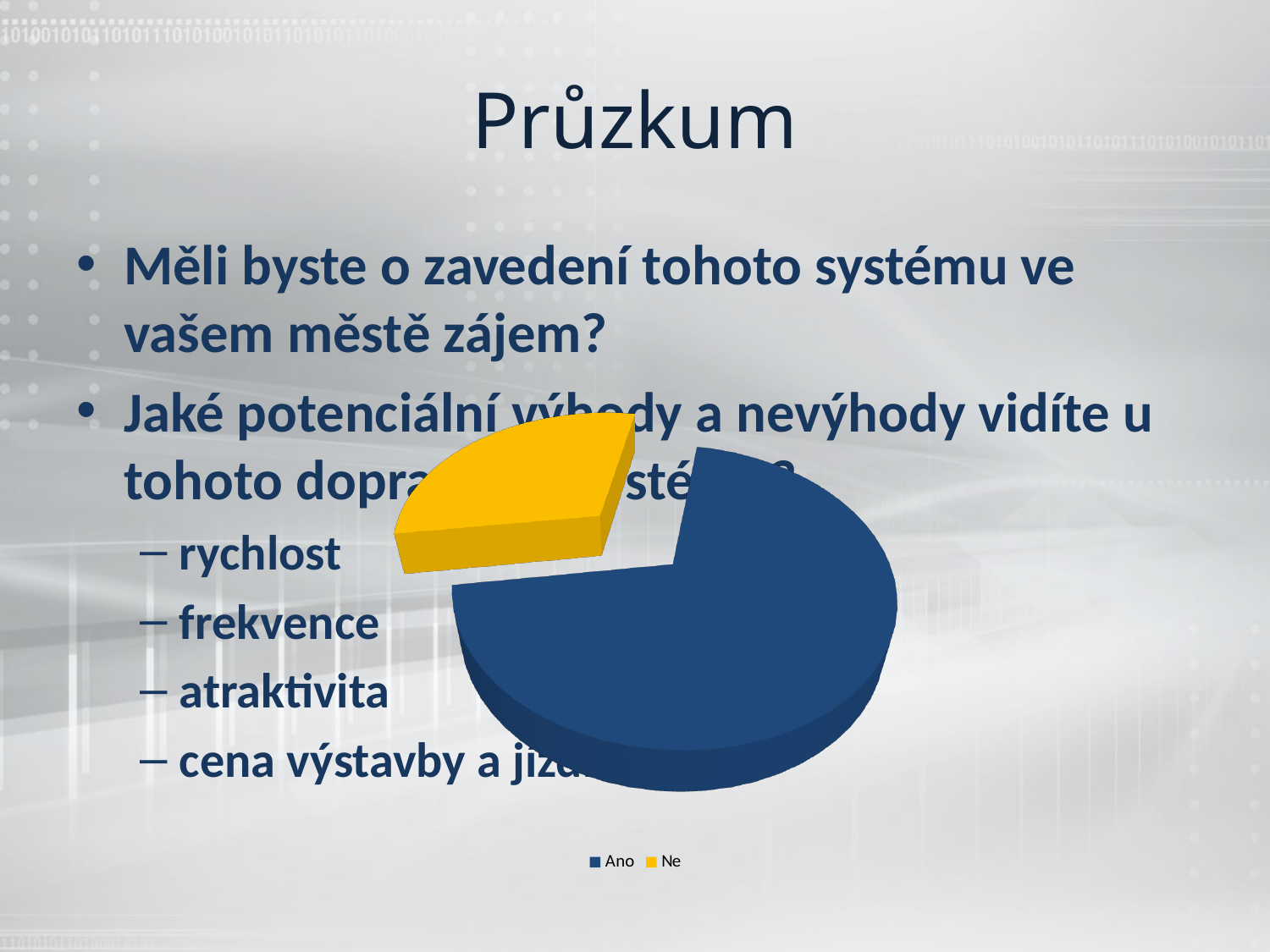
How many slices does the pie chart have? 2 How many entries does the legend of the pie chart list? 2 What kind of chart is shown on the slide? pie chart Which slice of the pie chart is the smallest? Ne Which slice of the pie chart is the largest? Ano What colour is the Ano slice in the pie chart? blue What are the two entries listed in the legend of the pie chart? Ano, Ne Which slice is larger in the pie chart, Ano or Ne? Ano